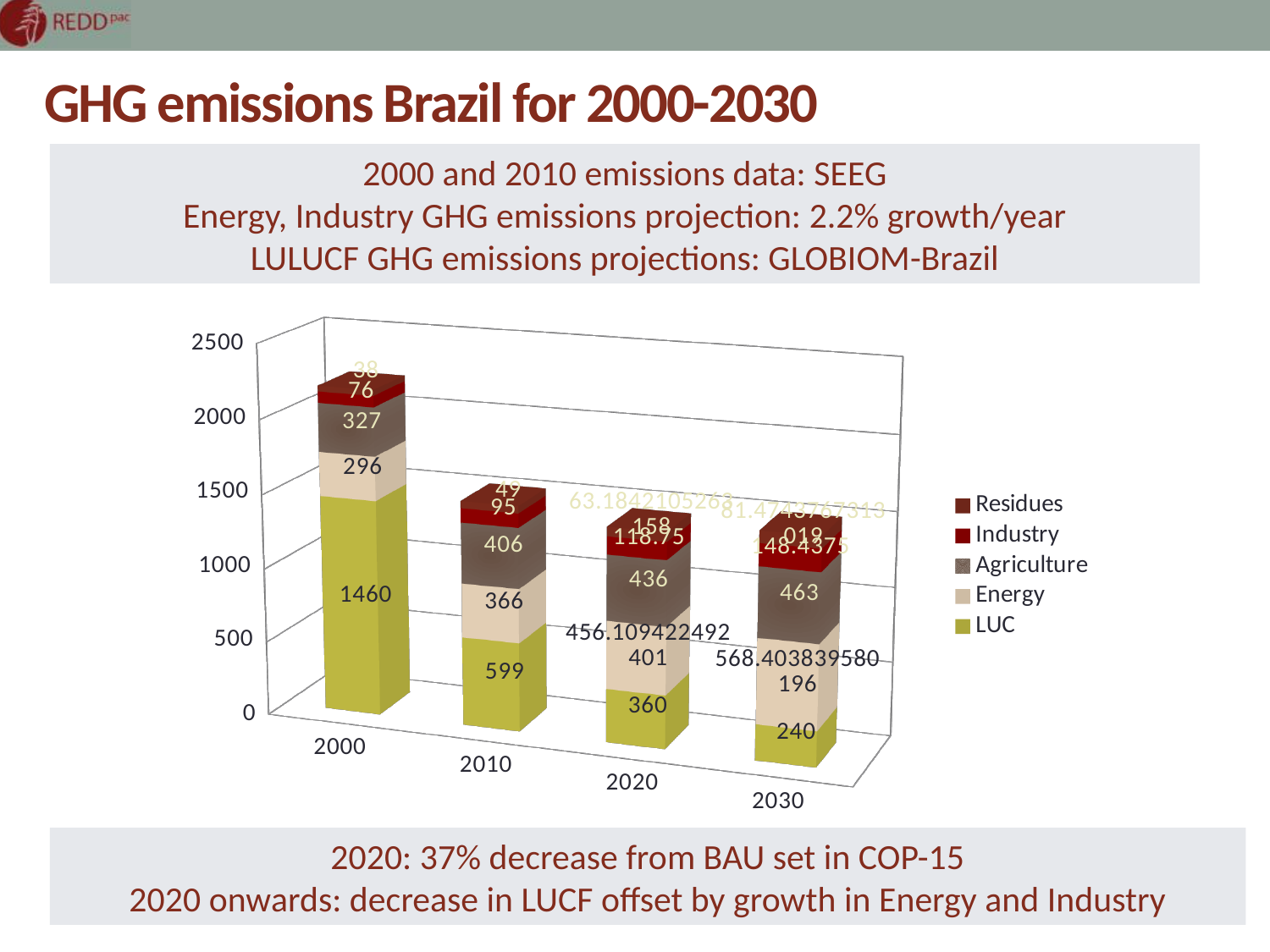
In which year is the LUC value highest? 2000 What kind of chart is shown on the slide? Stacked bar chart What is the total of the stacked bar for 2000? 2197 What is the LUC value for 2000? 1460 What is the difference between the LUC value in 2000 and in 2010? 861 What is the Energy value for 2010? 366 What is the Agriculture value for 2030? 463 How many series does the legend list? 5 What is the LUC value for 2020? 360 Does the LUC value rise or fall from 2000 to 2030? Fall How many years are shown along the x axis? 4 In 2020, which is larger: the Energy value or the Agriculture value? Energy